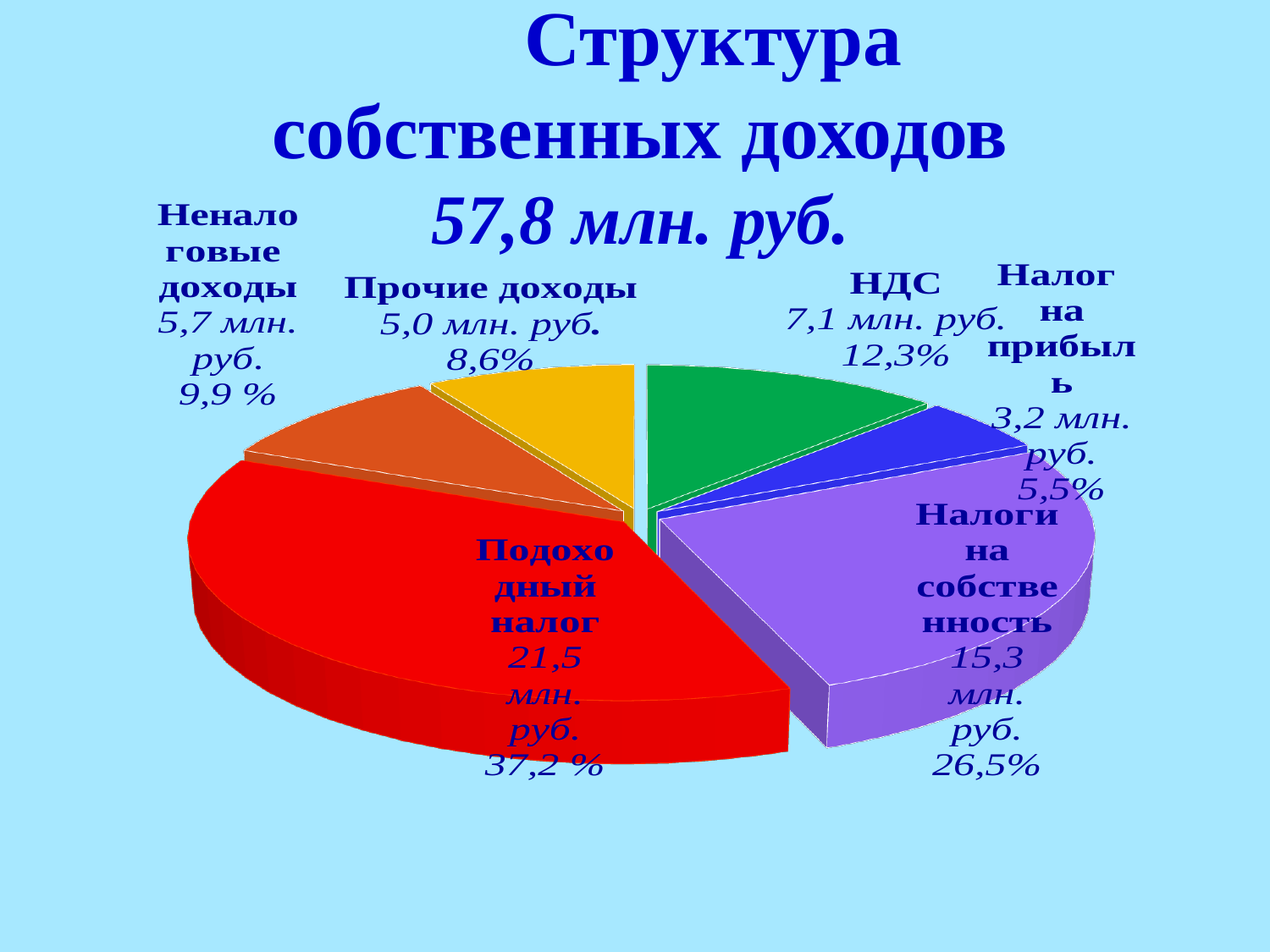
Which category has the largest share of the pie? Подоходный налог What total amount is stated in the chart title? 57,8 млн. руб. What is the value for Подоходный налог in млн. руб.? 21,5 млн. руб. What percentage share does Неналоговые доходы have? 9,9 % What is the value for Налоги на собственность in млн. руб.? 15,3 млн. руб. What colour is the slice for Налоги на собственность? Purple Which category has the smallest share of the pie? Налог на прибыль What kind of chart is shown on the slide? Pie chart What percentage share does НДС have? 12,3% How many slices does the pie chart have? 6 What is the difference in млн. руб. between Подоходный налог and Налоги на собственность? 6,2 млн. руб. Which is larger: Прочие доходы or Неналоговые доходы? Неналоговые доходы